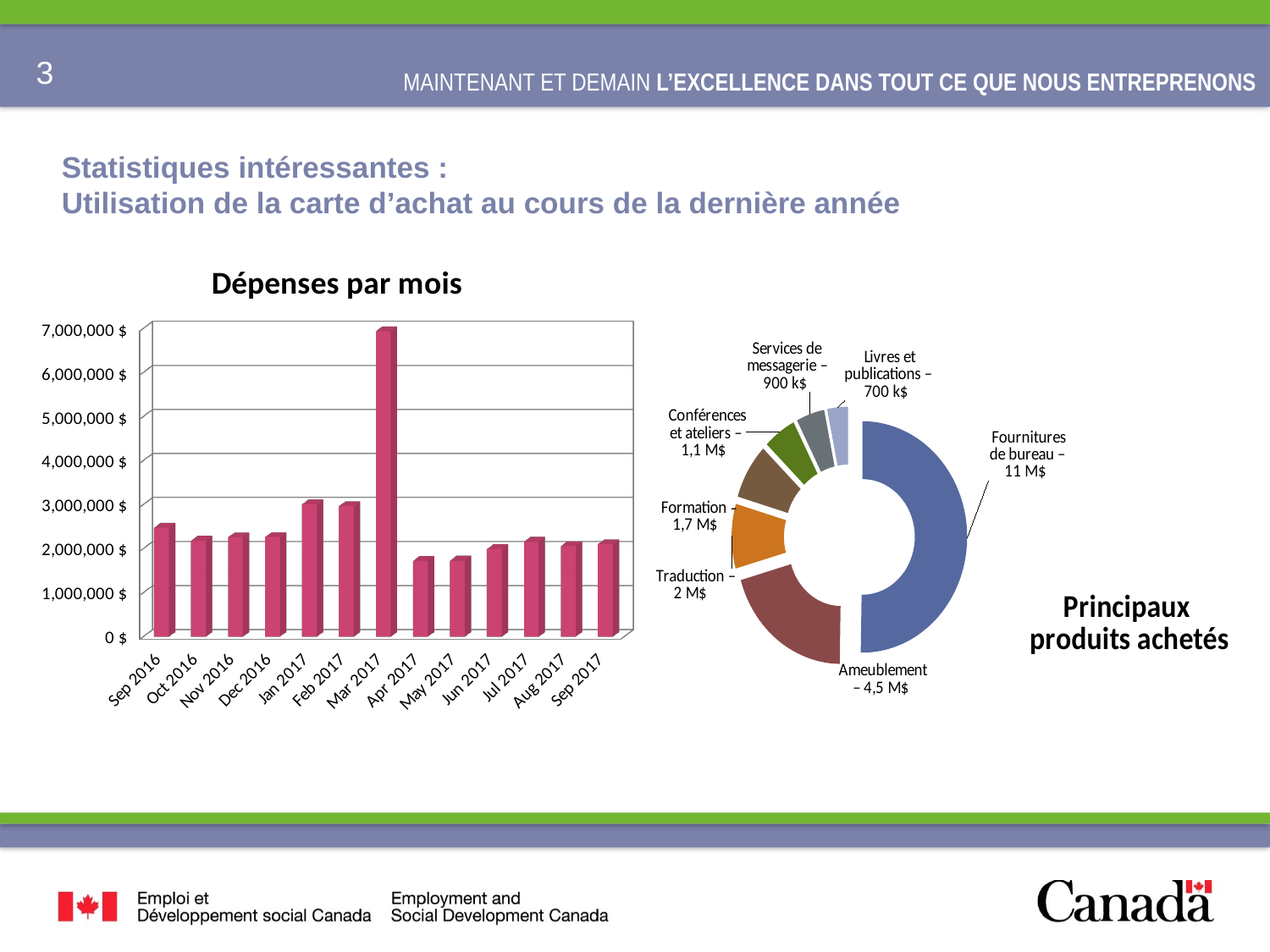
How many categories are shown in the 'Principaux produits achetés' chart? 7 In the 'Dépenses par mois' chart, is the value for Sep 2016 greater or less than 2,000,000 $? greater In the 'Dépenses par mois' chart, which month has the highest spending? Mar 2017 In the 'Principaux produits achetés' chart, which category has the smallest value? Livres et publications In the 'Principaux produits achetés' chart, what is the value for Ameublement? 4,5 M$ In the 'Dépenses par mois' chart, is the value for Apr 2017 greater or less than 2,000,000 $? less In the 'Principaux produits achetés' chart, what is the value for Fournitures de bureau? 11 M$ What kind of chart is 'Dépenses par mois'? Bar chart In the 'Dépenses par mois' chart, is the value for Mar 2017 greater or less than 6,000,000 $? greater How many months are shown in the 'Dépenses par mois' chart? 13 In the 'Principaux produits achetés' chart, which is larger: Traduction or Formation? Traduction In the 'Principaux produits achetés' chart, what is the difference between Fournitures de bureau and Ameublement? 6,5 M$